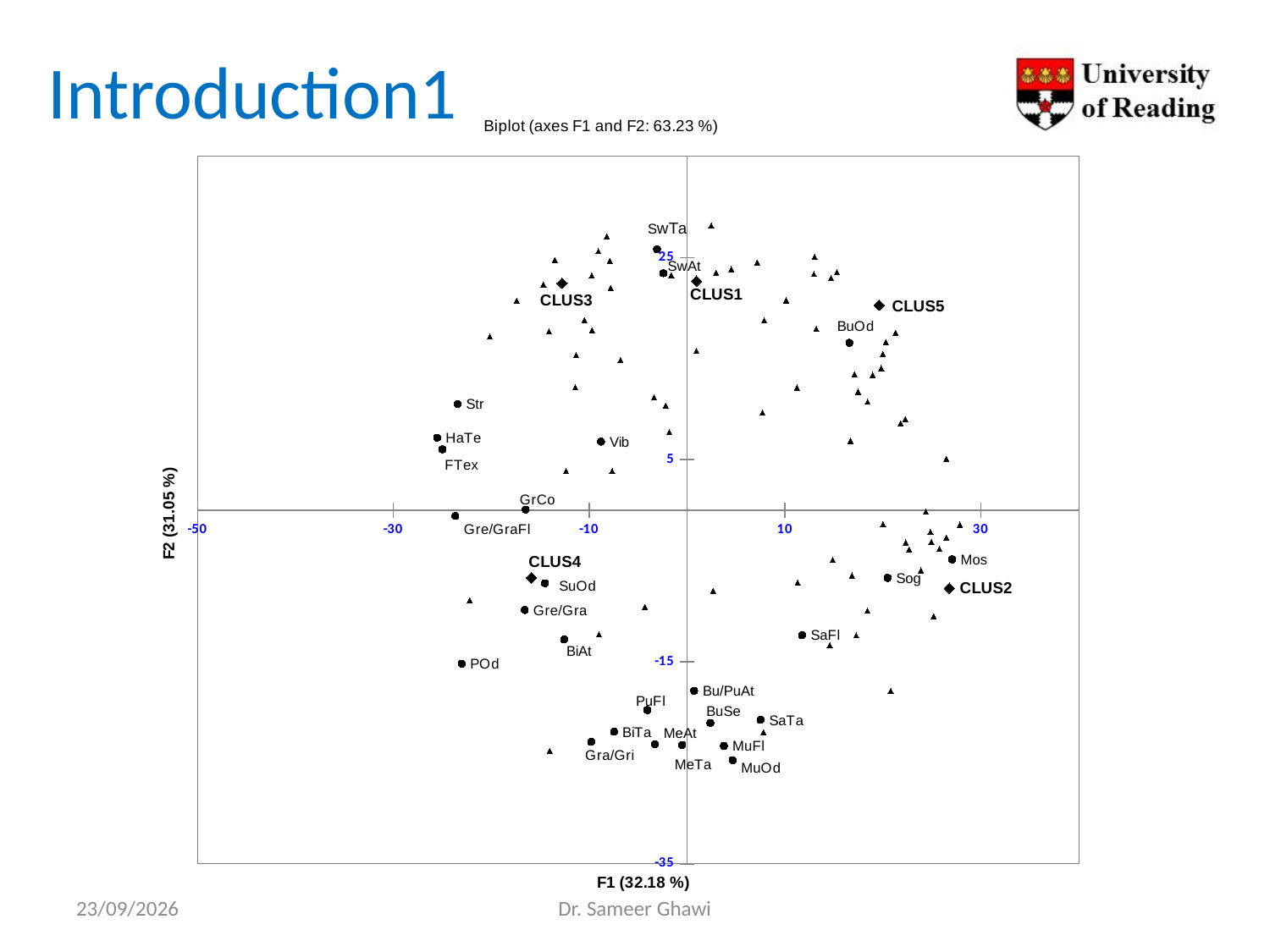
What kind of chart is shown on the slide? scatter chart (biplot) Is the F1 value for Mos greater or less than 10? greater Is the F2 value for MuOd greater or less than -15? less How many cluster centroids (CLUS points) are labelled on the chart? 5 Which point has the higher F2 value, Str or POd? Str What is the label of the horizontal axis? F1 (32.18 %) What is the title of the chart? Biplot (axes F1 and F2: 63.23 %) Is the F2 value for SwTa greater or less than 5? greater Which point has the higher F1 value, Mos or HaTe? Mos